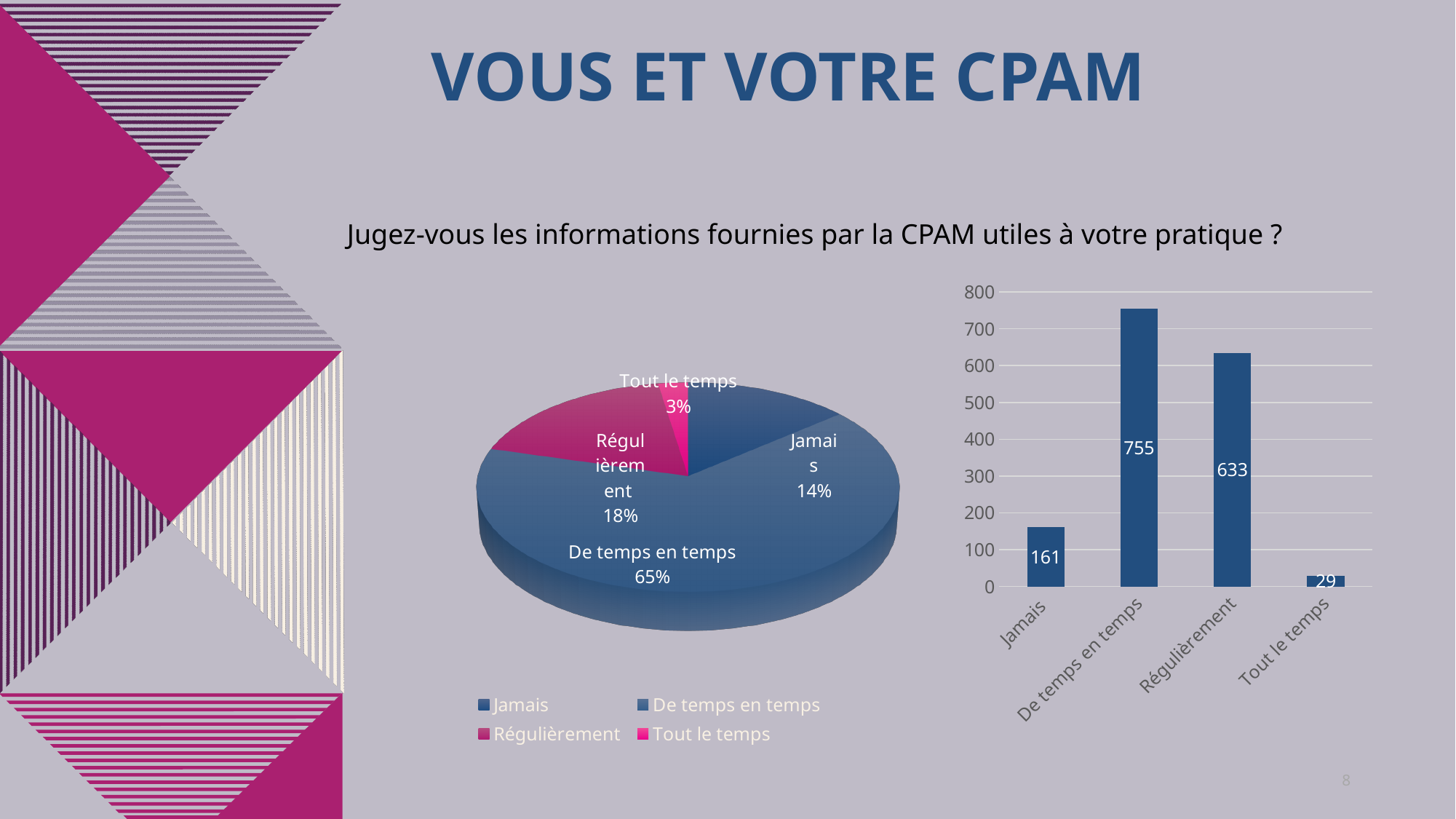
In the pie chart on the left, what share does De temps en temps have? 65% In the pie chart on the left, how many entries does the legend list? 4 In the bar chart on the right, which category has the highest value? De temps en temps In the bar chart on the right, what is the value for Jamais? 161 In the pie chart on the left, what share does Régulièrement have? 18% What kind of chart is the chart on the left? Pie chart In the bar chart on the right, what is the difference between the values for De temps en temps and Régulièrement? 122 In the bar chart on the right, what is the value for De temps en temps? 755 In the bar chart on the right, what is the value for Tout le temps? 29 In the bar chart on the right, which is larger, the value for Jamais or the value for Régulièrement? Régulièrement In the bar chart on the right, how many categories are shown on the x axis? 4 In the bar chart on the right, which category has the lowest value? Tout le temps